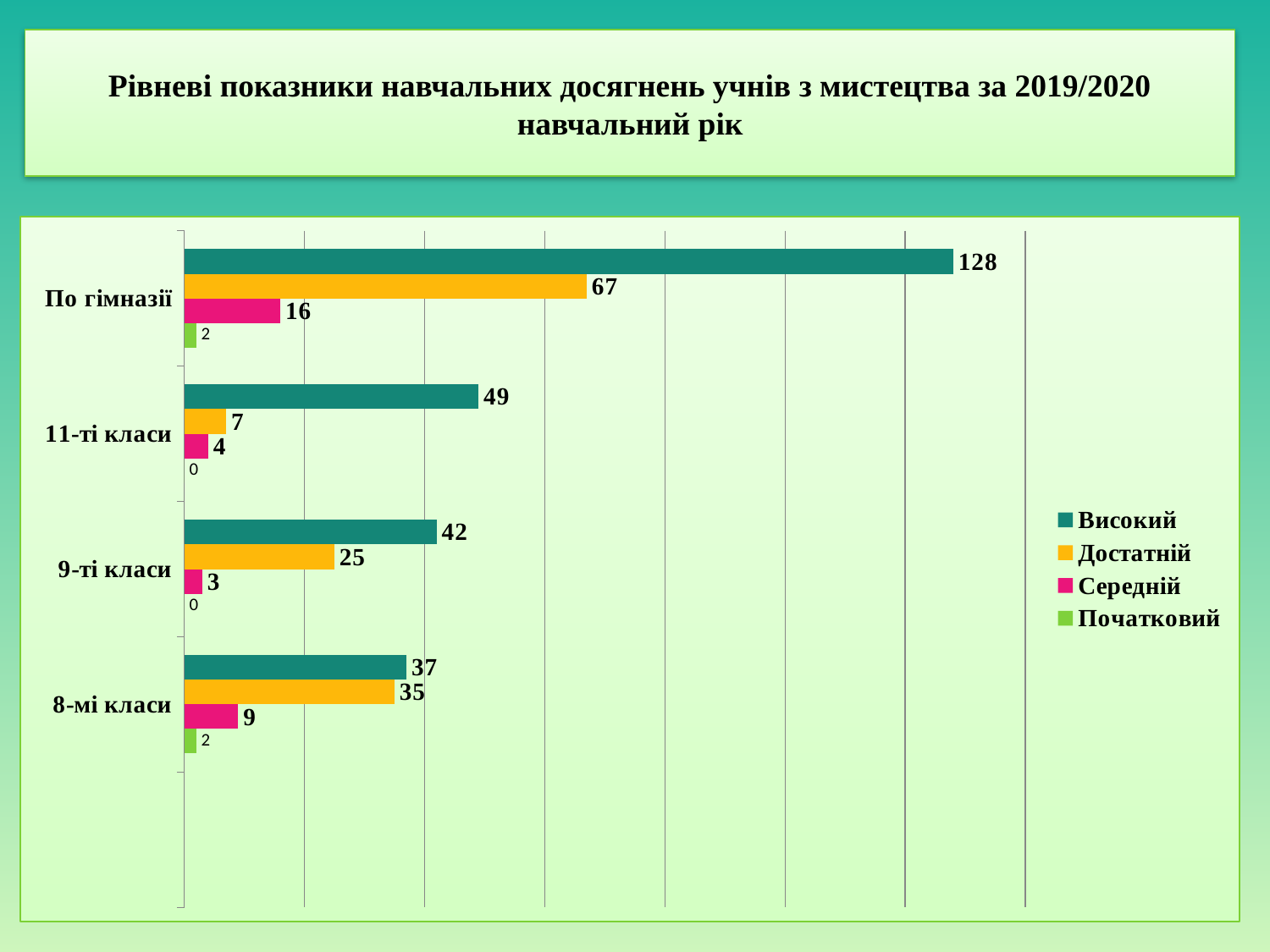
Among the class categories (excluding По гімназії), which has the lowest Достатній value? 11-ті класи How many series does the legend list? 4 How many categories are shown on the chart? 4 Which is larger for 8-мі класи: Високий or Достатній? Високий What is the value of Середній for 8-мі класи? 9 What kind of chart is shown on the slide? Bar chart What is the difference between the Високий and Достатній values for По гімназії? 61 Which category has the highest Високий value? По гімназії What is the value of Достатній for 9-ті класи? 25 What is the value of Початковий for 11-ті класи? 0 What is the value of Високий for По гімназії? 128 Which series is shown in pink on the chart? Середній